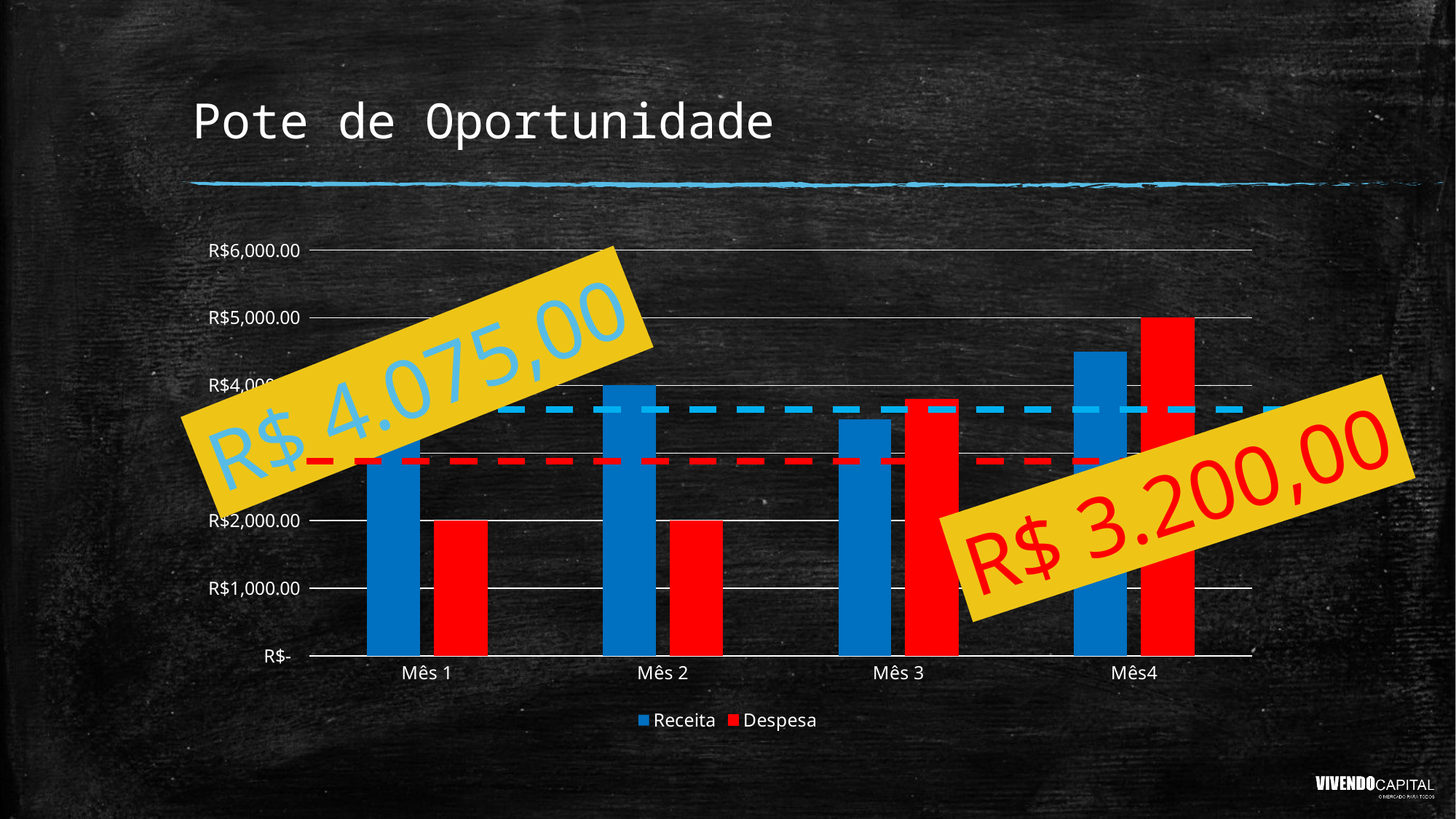
What is the Despesa value for Mês 1? R$2,000.00 Is the Receita value for Mês 3 greater or less than R$4,000.00? less How many months (categories) are shown on the x axis? 4 What is the title of the slide containing the chart? Pote de Oportunidade Which month has the highest Despesa? Mês4 What is the Receita value for Mês 2? R$4,000.00 In Mês4, which is larger, Receita or Despesa? Despesa What is the Despesa value for Mês4? R$5,000.00 Is the Receita value for Mês4 greater or less than R$4,000.00? greater What is the difference between the Despesa for Mês4 and the Despesa for Mês 2? R$3,000.00 What type of chart is shown on the slide? Bar chart How many series does the chart legend list? 2